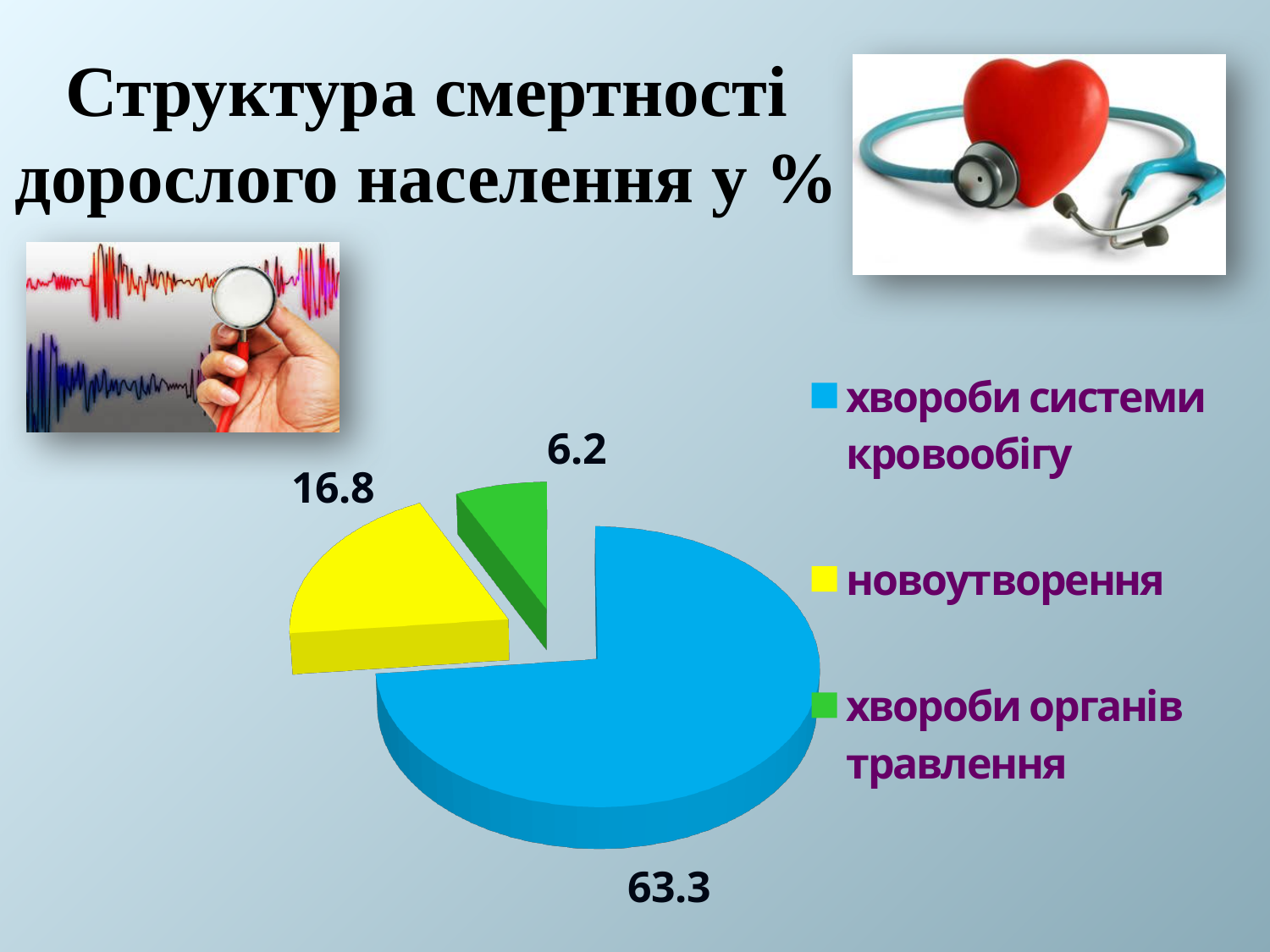
What is the title of the slide containing the chart? Структура смертності дорослого населення у % Which category has the smallest slice of the pie? хвороби органів травлення What value is shown for the slice "новоутворення"? 16.8 How many slices does the pie chart have? 3 What is the difference between the values for "новоутворення" and "хвороби органів травлення"? 10.6 What colour is the slice for "новоутворення"? yellow Which is larger: the value for "новоутворення" or the value for "хвороби органів травлення"? новоутворення Which category has the largest slice of the pie? хвороби системи кровообігу What value is shown for the slice "хвороби системи кровообігу"? 63.3 What value is shown for the slice "хвороби органів травлення"? 6.2 What is the difference between the values for "хвороби системи кровообігу" and "новоутворення"? 46.5 What kind of chart is shown on the slide? pie chart